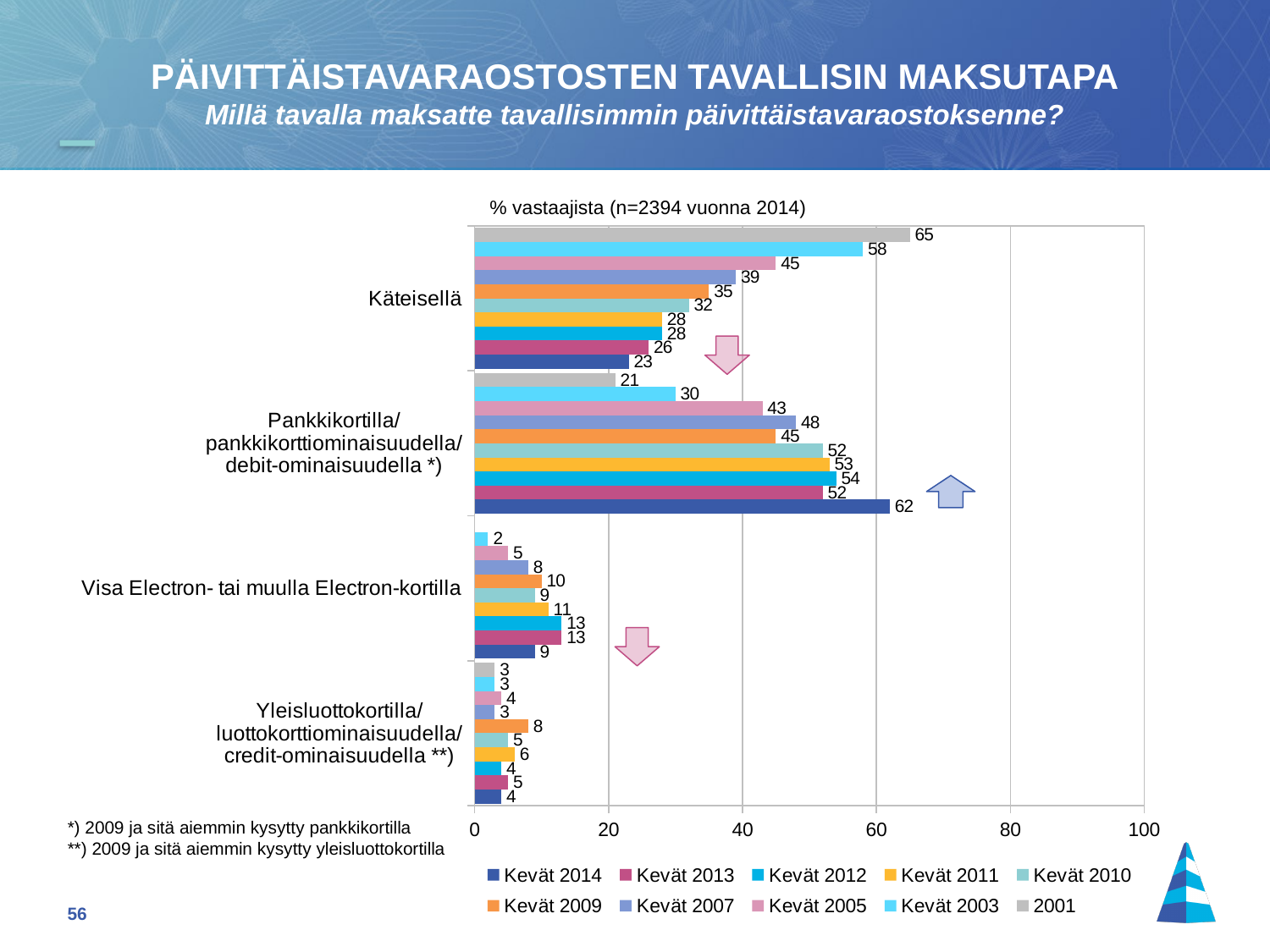
Is the value for Kevät 2003 in the Käteisellä category greater or less than 40? greater Which series has the highest value in the Käteisellä category? 2001 How many series does the legend list? 10 What is the value for Kevät 2014 in the Pankkikortilla/pankkikorttiominaisuudella/debit-ominaisuudella category? 62 What is the value for 2001 in the Käteisellä category? 65 What kind of chart is shown on the slide? Bar chart What is the difference between the 2001 and Kevät 2014 values in the Käteisellä category? 42 Do the values for Käteisellä rise or fall from 2001 to Kevät 2014? Fall Which series has the lowest value in the Pankkikortilla/pankkikorttiominaisuudella/debit-ominaisuudella category? 2001 What is the value for Kevät 2009 in the Yleisluottokortilla/luottokorttiominaisuudella/credit-ominaisuudella category? 8 In the Kevät 2014 series, which is larger: Käteisellä or Pankkikortilla/pankkikorttiominaisuudella/debit-ominaisuudella? Pankkikortilla/pankkikorttiominaisuudella/debit-ominaisuudella What is the value for Kevät 2014 in the Käteisellä category? 23